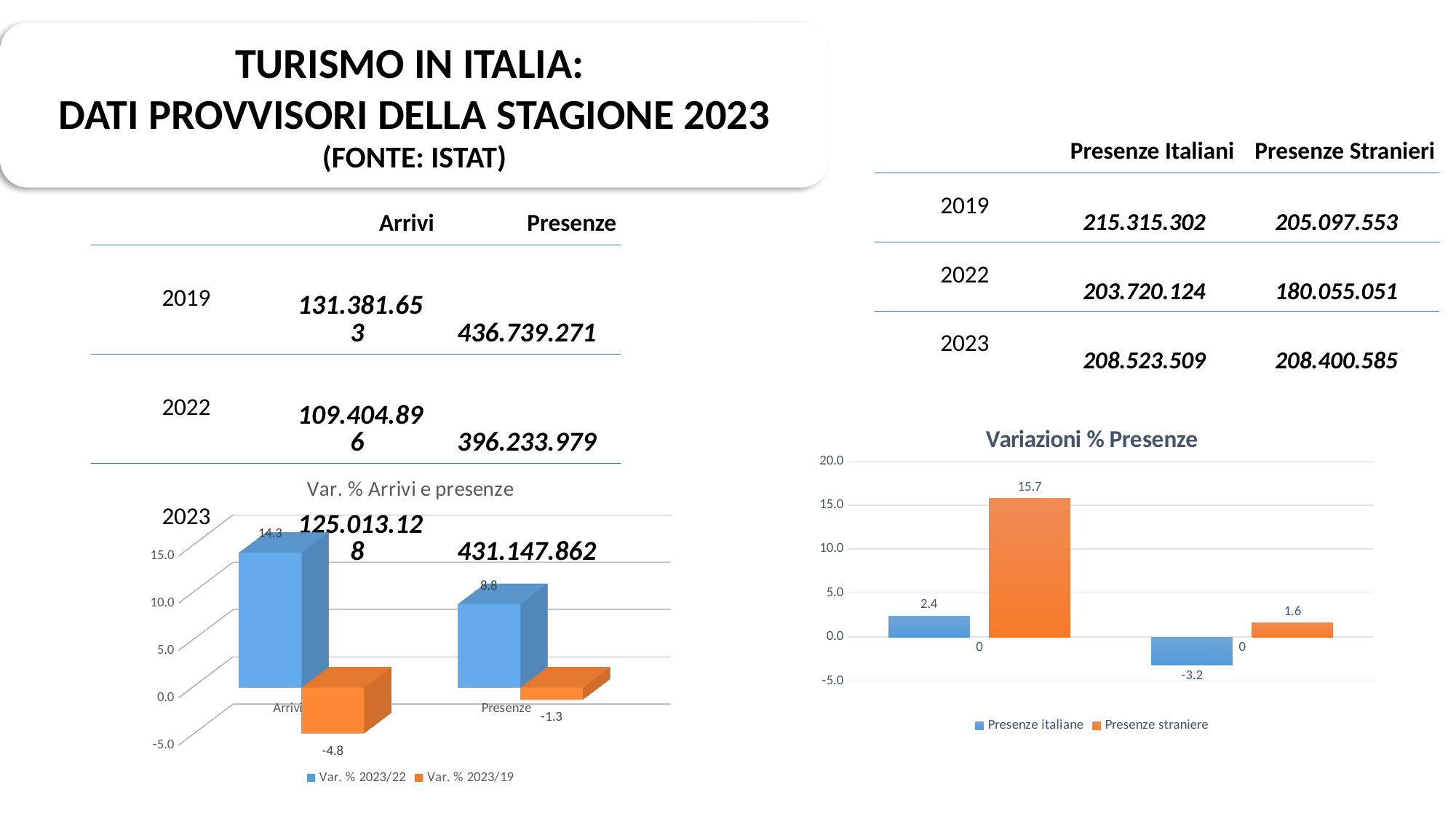
In the chart titled 'Var. % Arrivi e presenze', how many series does the legend list? 2 What kind of chart is the chart titled 'Variazioni % Presenze'? bar chart In the chart titled 'Var. % Arrivi e presenze', what is the value of Var. % 2023/19 for Presenze? -1.3 In the chart titled 'Variazioni % Presenze', is the value 15.7 for Presenze straniere greater or less than 10.0 on the axis? greater In the chart titled 'Var. % Arrivi e presenze', what is the difference between the Var. % 2023/22 values for Arrivi and Presenze? 5.5 In the chart titled 'Variazioni % Presenze', what is the highest value shown for Presenze straniere? 15.7 In the chart titled 'Var. % Arrivi e presenze', what is the value of Var. % 2023/22 for Arrivi? 14.3 In the chart titled 'Var. % Arrivi e presenze', what is the value of Var. % 2023/22 for Presenze? 8.8 In the chart titled 'Var. % Arrivi e presenze', what is the value of Var. % 2023/19 for Arrivi? -4.8 In the chart titled 'Var. % Arrivi e presenze', how many categories are shown on the x axis? 2 In the chart titled 'Variazioni % Presenze', what is the value of the first Presenze italiane bar? 2.4 In the chart titled 'Variazioni % Presenze', what is the lowest value shown for Presenze italiane? -3.2